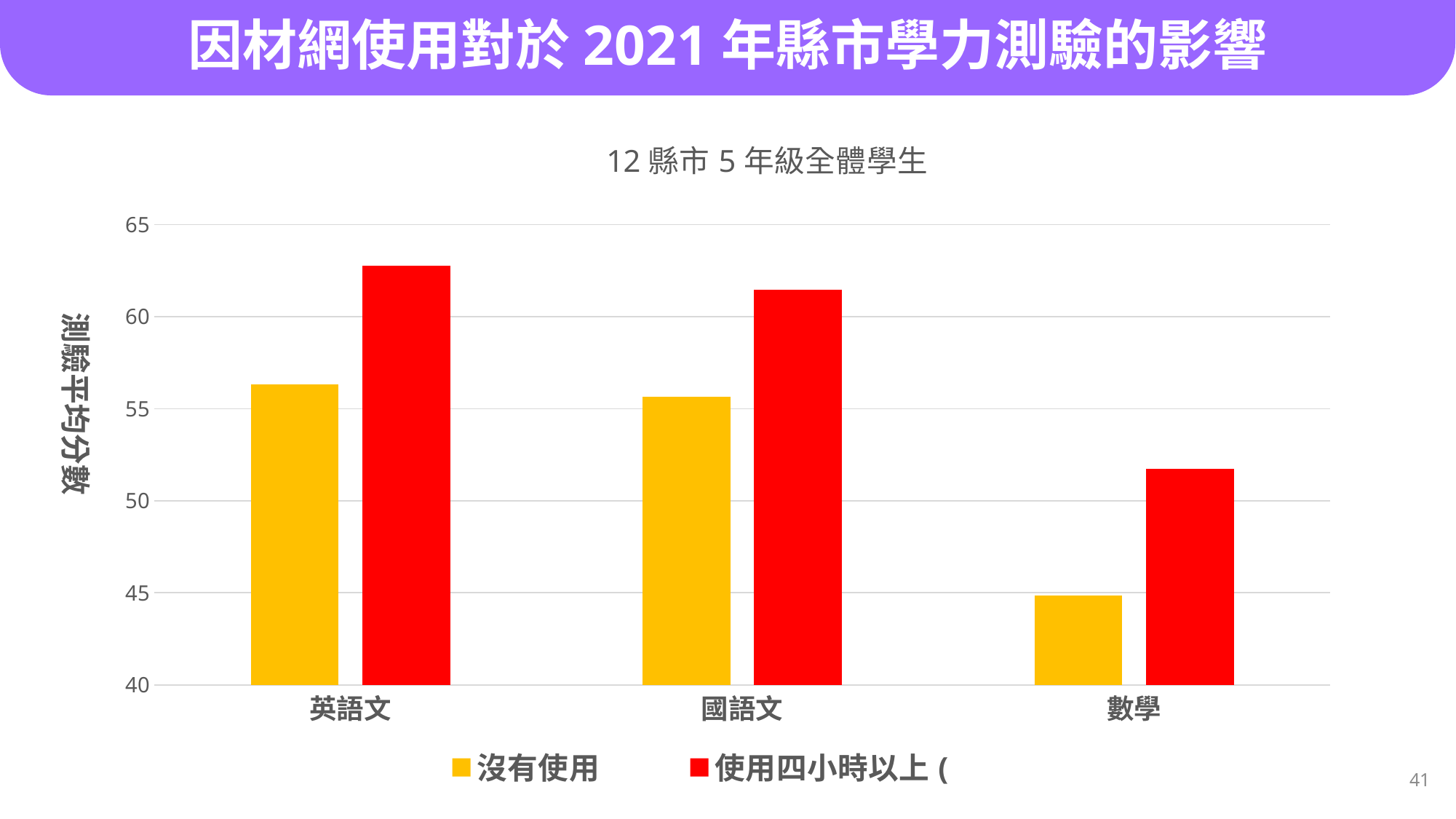
What is the label on the vertical axis? 測驗平均分數 What is the title of the chart? 12 縣市 5 年級全體學生 Which subject has the lowest value for 使用四小時以上? 數學 Is the value for 使用四小時以上 in 數學 greater or less than 50? greater Is the value for 沒有使用 in 數學 greater or less than 50? less For 數學, which is larger: 沒有使用 or 使用四小時以上? 使用四小時以上 For 英語文, which is larger: 沒有使用 or 使用四小時以上? 使用四小時以上 How many subject categories are shown on the x axis? 3 What kind of chart is shown on the slide? bar chart How many series does the legend list? 2 Which subject has the lowest value for 沒有使用? 數學 Is the value for 使用四小時以上 in 英語文 greater or less than 60? greater